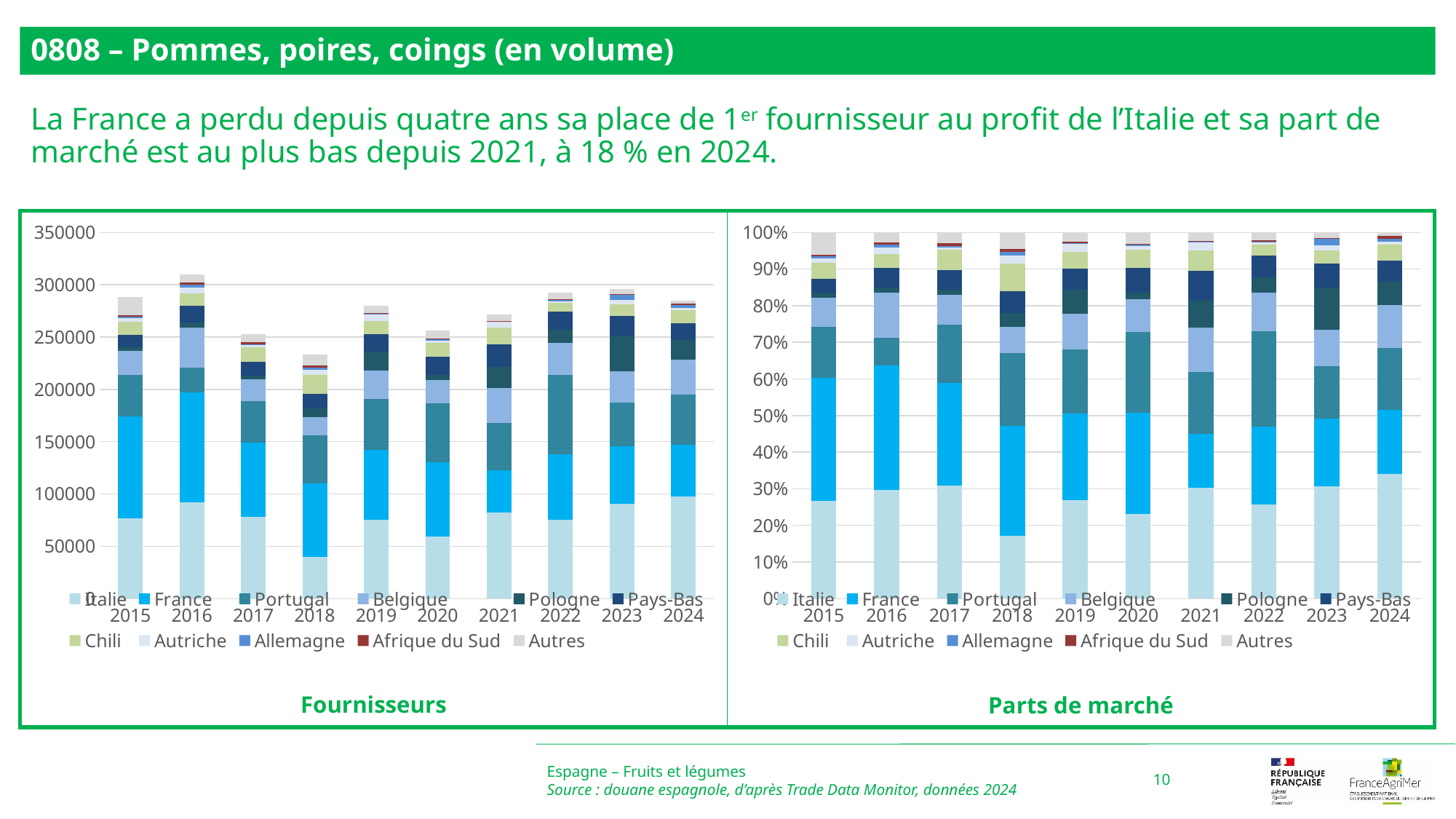
In the 'Fournisseurs' chart, is the total for 2018 greater or less than 250000? less In the 'Fournisseurs' chart, is the total for 2016 greater or less than 300000? greater In the 'Fournisseurs' chart, is the Italie value for 2018 greater or less than 50000? less How many series does the legend of the 'Parts de marché' chart list? 11 In the 'Fournisseurs' chart, which year has the highest total bar? 2016 How many years are shown on the x axis of the 'Fournisseurs' chart? 10 In the 'Fournisseurs' chart, which year has the lowest total bar? 2018 What is the title of the chart on the right of the slide? Parts de marché In the 'Fournisseurs' chart, which is larger: the Italie value in 2024 or the Italie value in 2018? 2024 In the 'Fournisseurs' chart, do the total bars rise or fall from 2018 to 2023? rise What kind of chart is the 'Fournisseurs' chart on the left? stacked bar chart